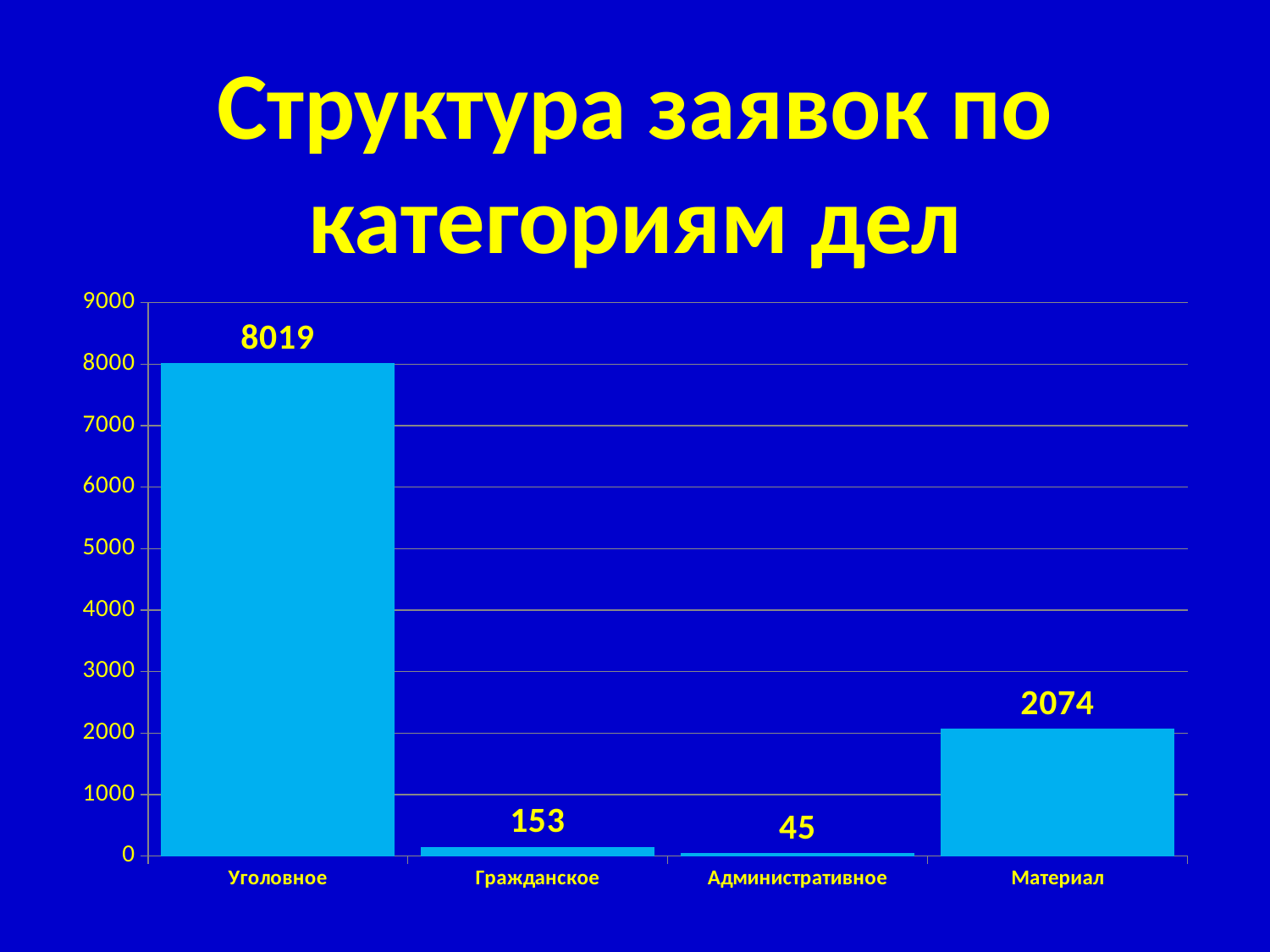
What is the value for Материал? 2074 What kind of chart is shown on the slide? bar chart Which category has the lowest value? Административное What is the difference between the values for Уголовное and Материал? 5945 Is the value for Материал greater or less than 3000? less Which category has the highest value? Уголовное What is the value for Административное? 45 Which is larger, the value for Материал or the value for Гражданское? Материал What is the difference between the values for Гражданское and Административное? 108 How many categories are shown on the x axis? 4 What is the value for Гражданское? 153 What is the value for Уголовное? 8019